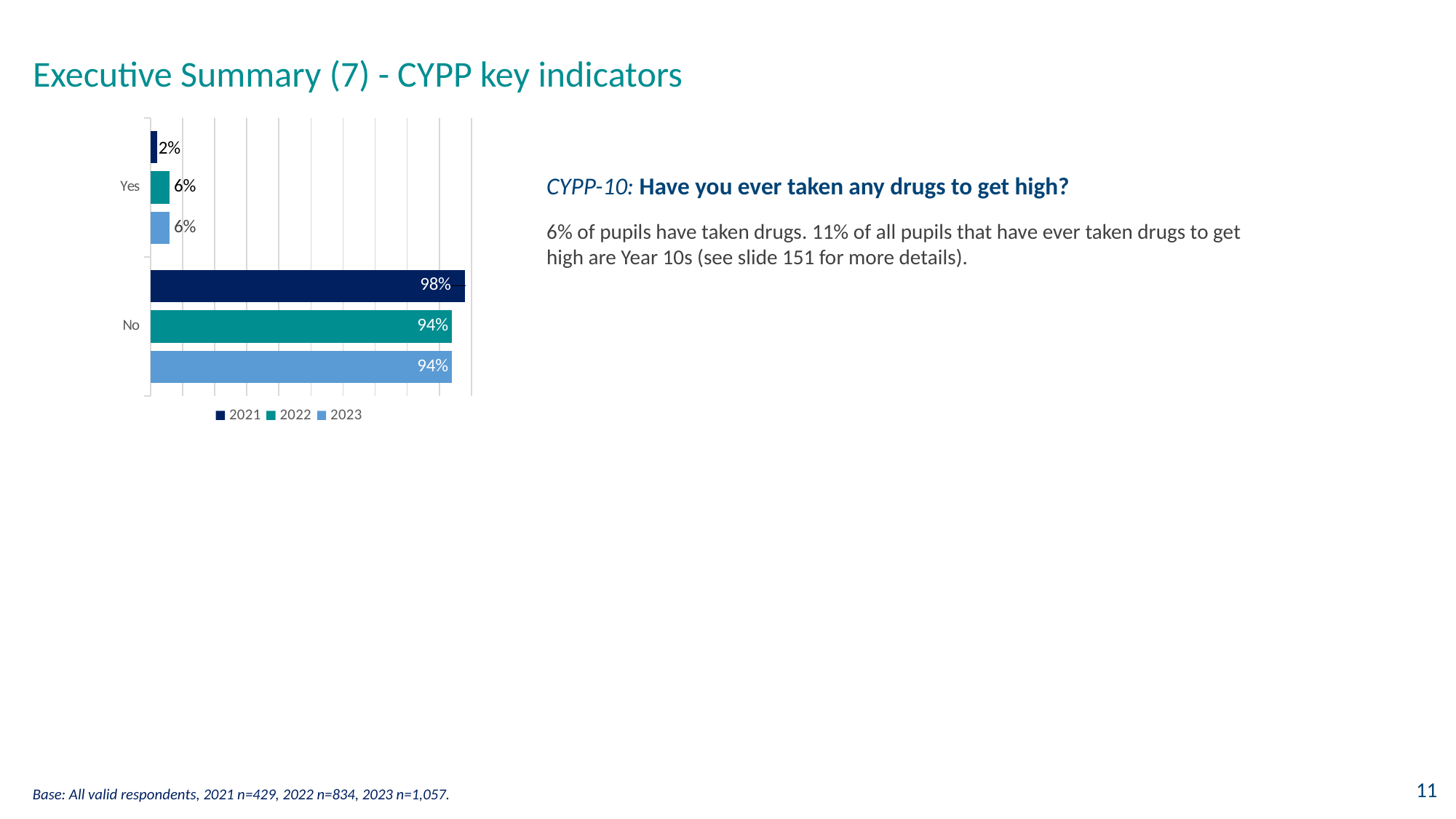
Which year has the lowest value for 'Yes'? 2021 How many response categories are shown on the chart? 2 Which is larger, the 'Yes' value for 2022 or the 'Yes' value for 2021? 2022 What percentage of pupils answered 'Yes' in 2021? 2% How many series does the legend list? 3 What percentage of pupils answered 'No' in 2021? 98% Which years are listed in the chart legend? 2021, 2022, 2023 Which year has the highest value for 'No'? 2021 What is the difference between the 'No' values for 2021 and 2023? 4% What percentage of pupils answered 'No' in 2022? 94% What percentage of pupils answered 'Yes' in 2023? 6% What kind of chart is shown on the slide? Bar chart